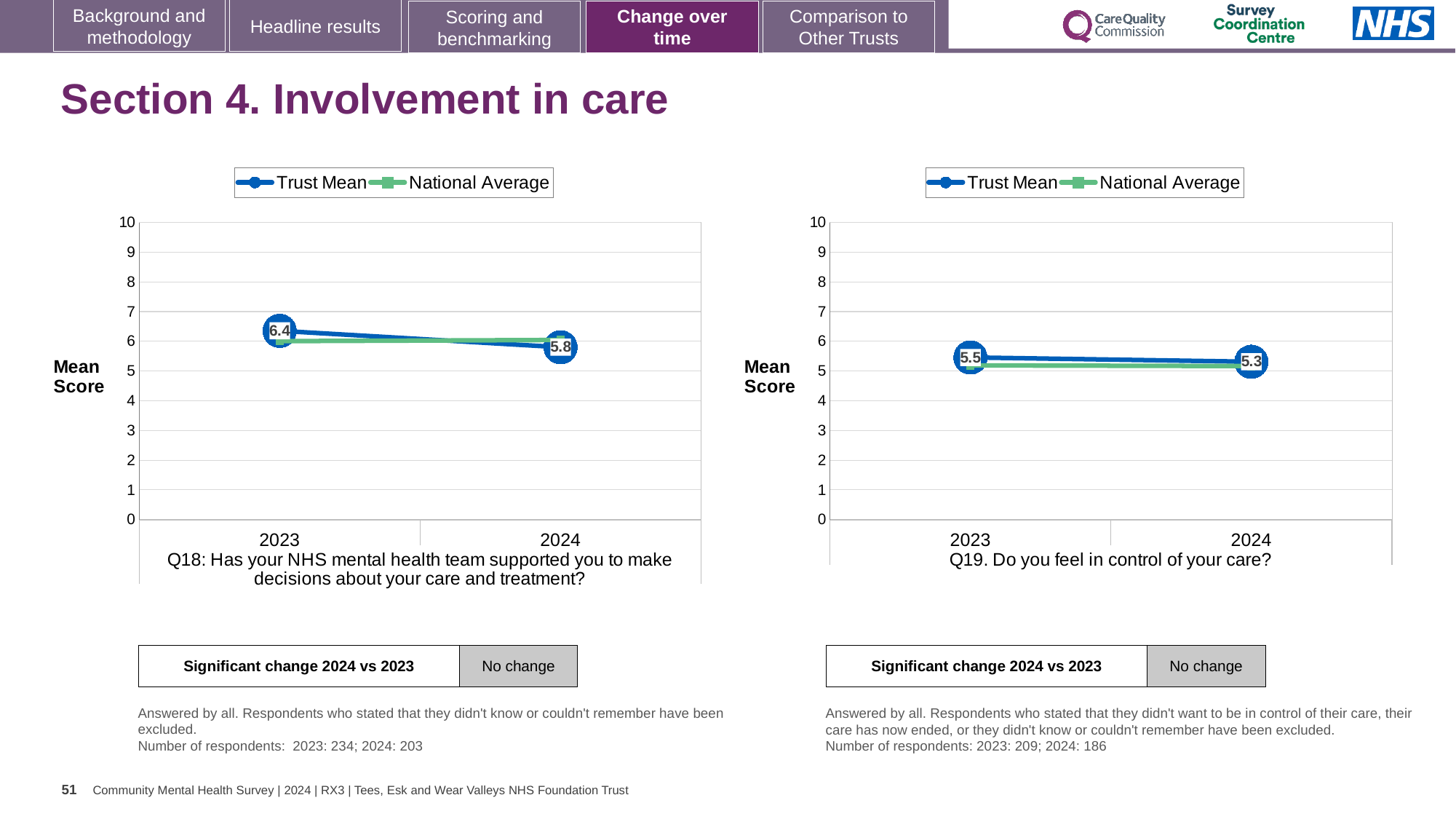
In the Q19 chart on the right, what is the difference between the Trust Mean scores for 2023 and 2024? 0.2 How many series does the legend of the Q19 chart on the right list? 2 In the Q18 chart on the left, what is the Trust Mean score for 2023? 6.4 In the Q19 chart on the right, what is the Trust Mean score for 2023? 5.5 In the Q19 chart on the right, is the National Average value for 2024 greater or less than 6? less What kind of chart is the Q19 chart on the right? line chart In the Q18 chart on the left, does the Trust Mean rise or fall from 2023 to 2024? fall In the Q18 chart on the left, which year has the higher Trust Mean score, 2023 or 2024? 2023 In the Q19 chart on the right, what is the Trust Mean score for 2024? 5.3 In the Q18 chart on the left, by how much did the Trust Mean score change from 2023 to 2024? 0.6 In the Q18 chart on the left, what is the Trust Mean score for 2024? 5.8 How many years are plotted on the x axis of the Q18 chart on the left? 2